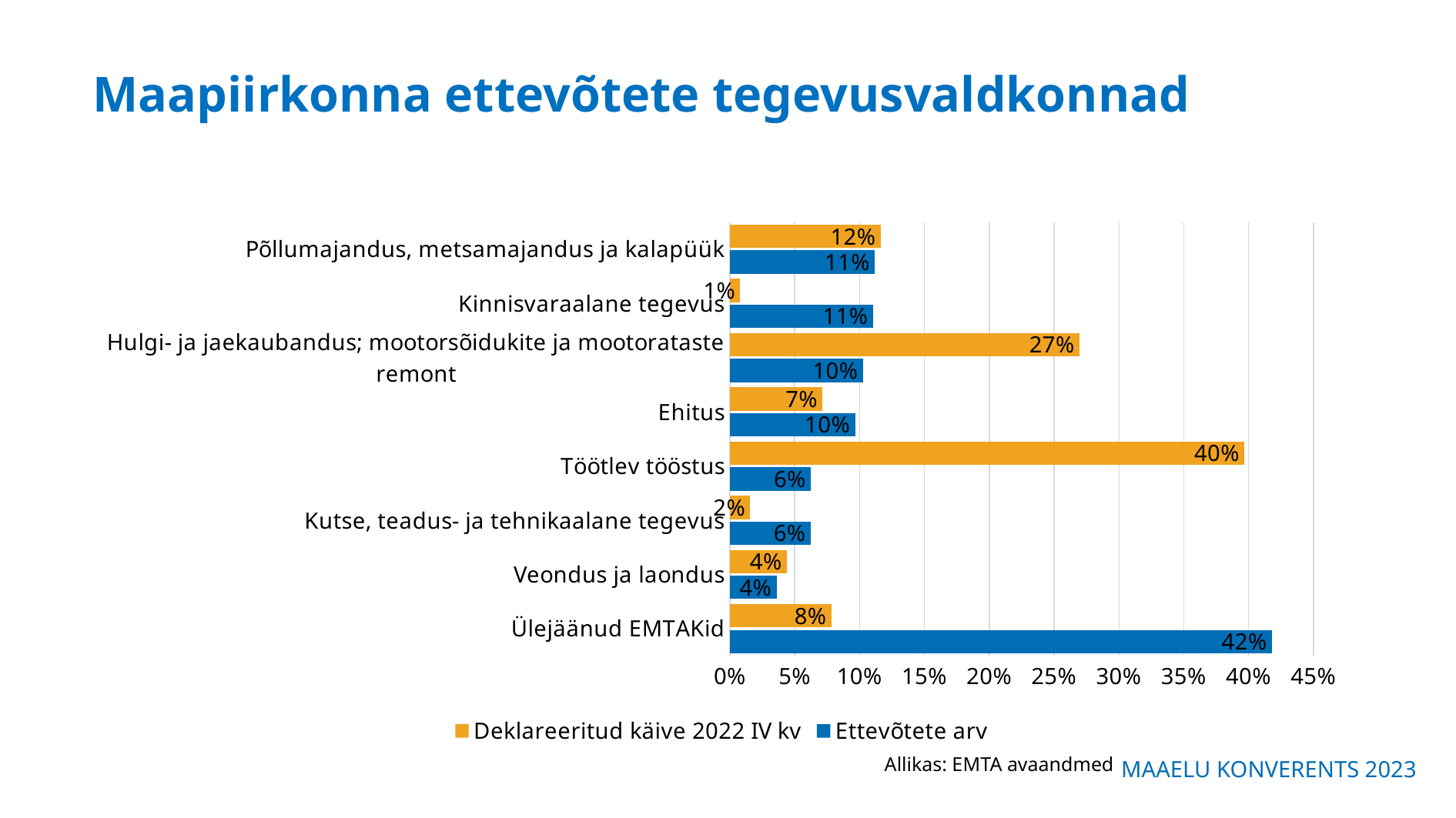
For Ehitus, which is larger: Deklareeritud käive 2022 IV kv or Ettevõtete arv? Ettevõtete arv What is the value of Deklareeritud käive 2022 IV kv for Töötlev tööstus? 40% What is the title of the slide? Maapiirkonna ettevõtete tegevusvaldkonnad How many categories are shown on the chart? 8 Which category has the highest value for Deklareeritud käive 2022 IV kv? Töötlev tööstus What is the value of Ettevõtete arv for Ülejäänud EMTAKid? 42% What is the value of Ettevõtete arv for Kinnisvaraalane tegevus? 11% What is the value of Deklareeritud käive 2022 IV kv for Hulgi- ja jaekaubandus; mootorsõidukite ja mootorrataste remont? 27% What kind of chart is shown on the slide? Bar chart What is the difference between Deklareeritud käive 2022 IV kv and Ettevõtete arv for Töötlev tööstus? 34% Which category has the lowest value for Deklareeritud käive 2022 IV kv? Kinnisvaraalane tegevus How many series does the legend list? 2